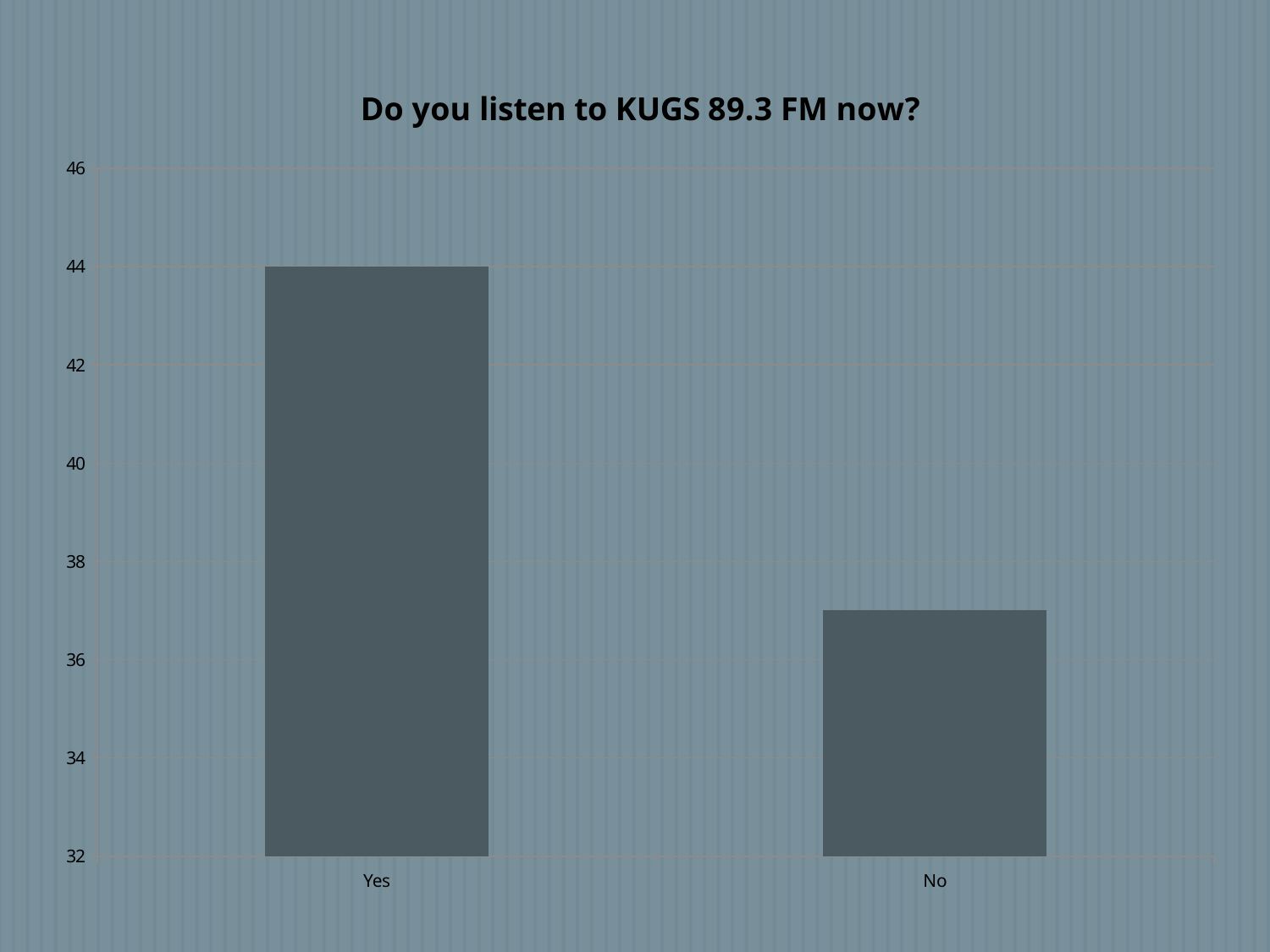
Which is larger, the value for Yes or the value for No? Yes What is the value for Yes? 44 Is the value for No greater or less than 38? less Is the value for No greater or less than 36? greater Do the values rise or fall from Yes to No along the x axis? fall Which category has the lowest value? No What kind of chart is shown on the slide? bar chart What is the title of the chart? Do you listen to KUGS 89.3 FM now? What is the lowest value shown on the vertical axis? 32 Which category has the highest value? Yes Is the value for Yes greater or less than 42? greater How many categories are shown on the x axis? 2